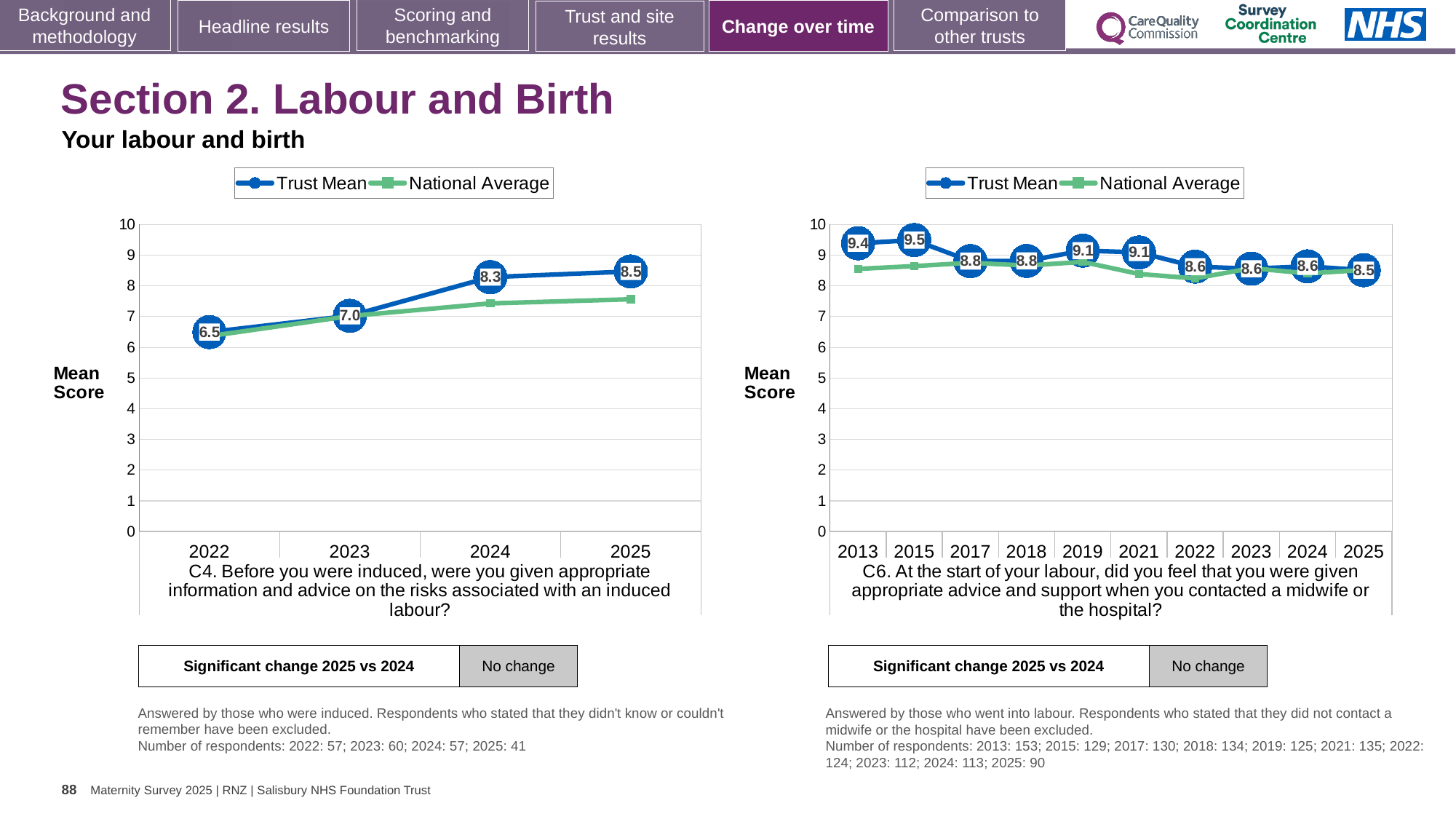
In the left chart (C4), does the Trust Mean rise or fall from 2022 to 2025? rise In the left chart (C4), by how much did the Trust Mean rise from 2022 to 2025? 2.0 In the right chart (C6), which year has the lowest Trust Mean score? 2025 In the right chart (C6), which year has the highest Trust Mean score? 2015 In the right chart (C6), what is the Trust Mean score for 2015? 9.5 In the left chart (C4), is the National Average for 2025 greater or less than 8? less In the left chart (C4), how many years are plotted on the x axis? 4 In the right chart (C6), how many years are plotted on the x axis? 10 How many series does the legend of the right chart (C6) list? 2 In the left chart (C4), what is the Trust Mean score for 2024? 8.3 In the right chart (C6), what is the difference between the Trust Mean in 2013 and in 2025? 0.9 In the left chart (C4), what is the Trust Mean score for 2022? 6.5